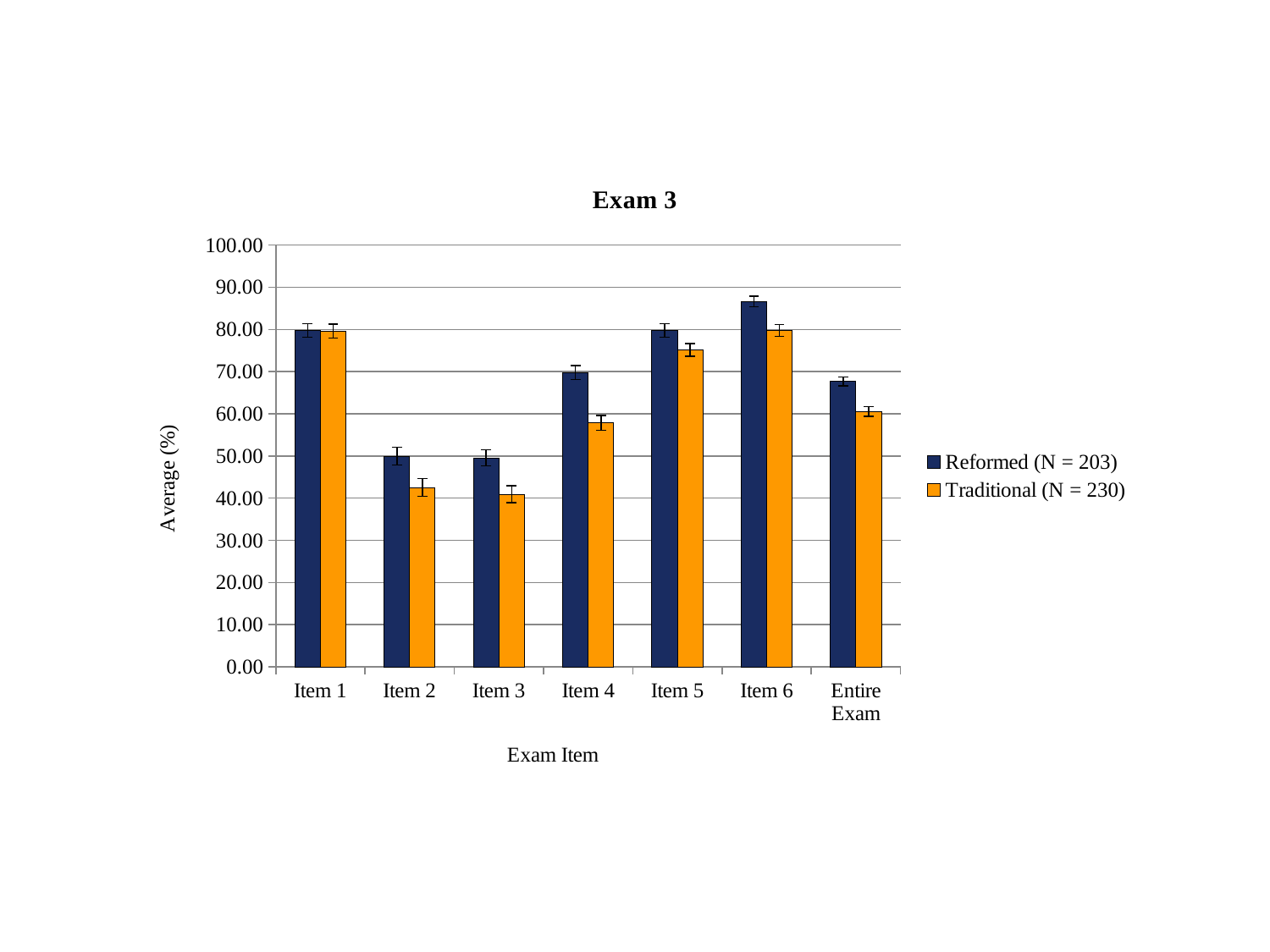
What kind of chart is shown on the slide? bar chart Which category has the highest value for the Reformed (N = 203) series? Item 6 Is the Reformed (N = 203) value for Item 6 greater or less than 80.00? greater Is the Reformed (N = 203) value for Item 4 greater or less than 60.00? greater What is the title of the chart? Exam 3 Is the Traditional (N = 230) value for Item 2 greater or less than 50.00? less For the Entire Exam category, which series has the larger value, Reformed (N = 203) or Traditional (N = 230)? Reformed (N = 203) How many series does the legend list? 2 For Item 4, which series has the larger value, Reformed (N = 203) or Traditional (N = 230)? Reformed (N = 203) What is the label of the y axis? Average (%) How many categories are shown on the x axis? 7